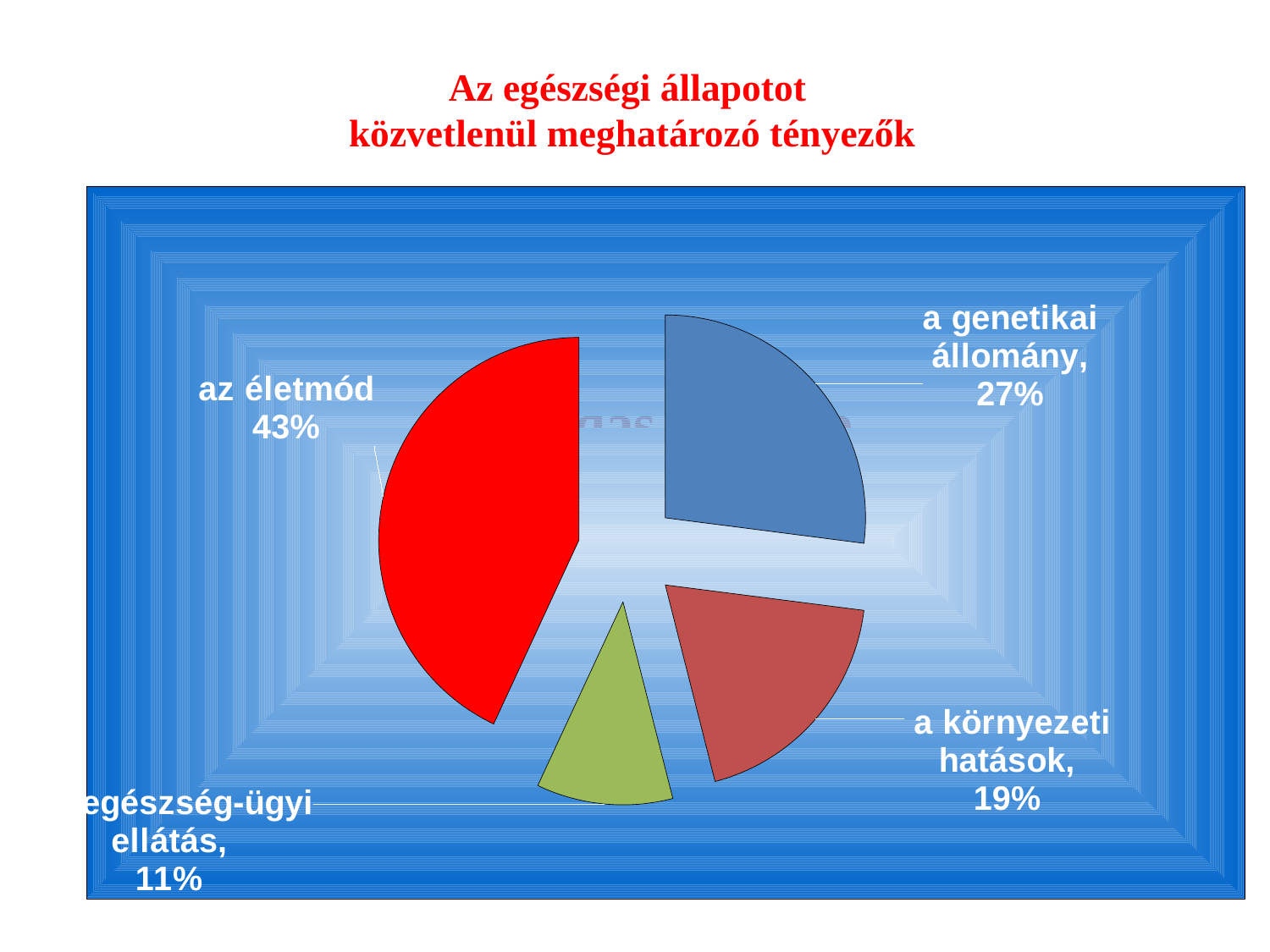
What share of the pie does "a környezeti hatások" represent? 19% What colour is the slice for "az életmód"? red What is the title of the slide containing the pie chart? Az egészségi állapotot közvetlenül meghatározó tényezők What share of the pie does "egészség-ügyi ellátás" represent? 11% Which is larger, the share for "a környezeti hatások" or the share for "egészség-ügyi ellátás"? a környezeti hatások Which slice of the pie is the smallest? egészség-ügyi ellátás What kind of chart is shown on the slide? pie chart How many slices does the pie chart have? 4 Which slice of the pie is the largest? az életmód What share of the pie does "a genetikai állomány" represent? 27% What share of the pie does "az életmód" represent? 43% What is the difference in percentage points between "az életmód" and "a genetikai állomány"? 16